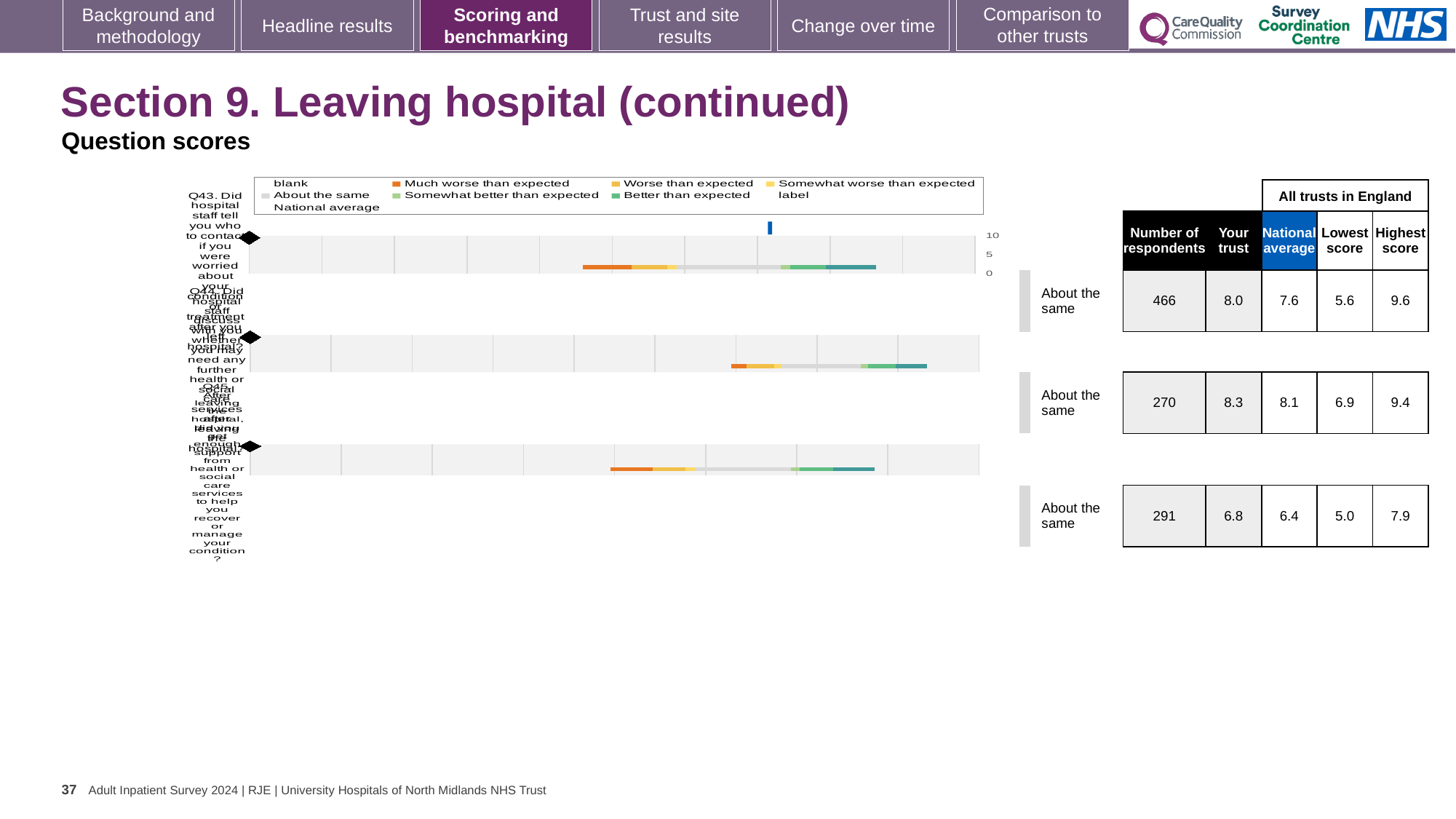
How many question score charts are shown on the slide? 3 Which of the three charts has the lowest 'Lowest score' value? the bottom chart (Q45), 5.0 For the top chart (Q43), what is the difference between the highest score and the lowest score among all trusts in England? 4.0 Which of the three charts has the highest 'Your trust' score? the second chart (Q44), 8.3 For the top chart (Q43), what is the national average score? 7.6 For the second chart (Q44), how many respondents are listed? 270 For the second chart (Q44), what is the difference between the 'Your trust' score and the national average? 0.2 For the bottom chart (Q45), what is the highest score among all trusts in England? 7.9 What benchmark rating is shown next to each of the three charts? About the same What kind of chart is used to show the question scores on this slide? bar chart For the bottom chart (Q45), which is larger: the 'Your trust' score or the national average? Your trust For the top chart (Q43), what is the 'Your trust' score shown in the table? 8.0